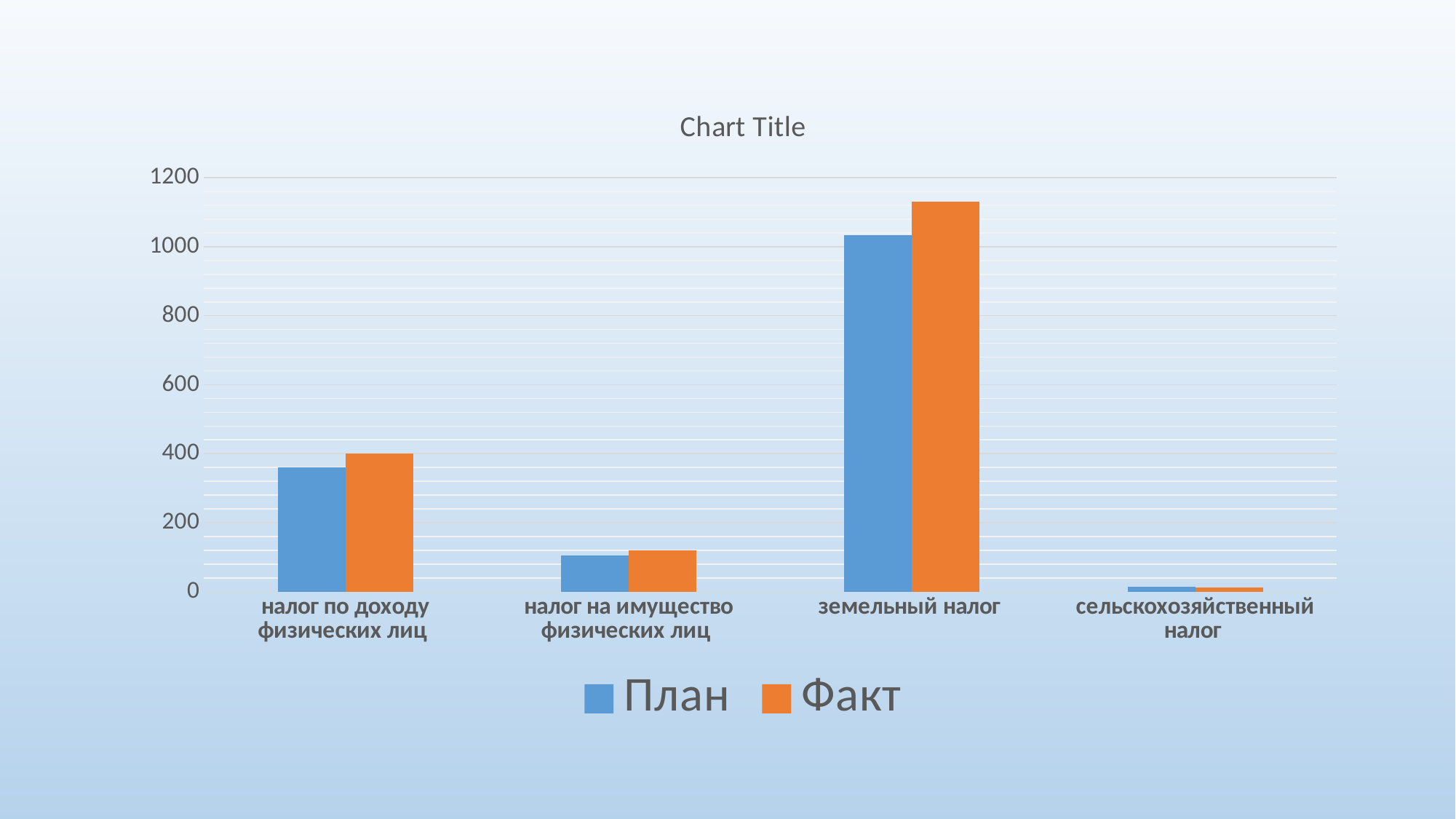
Is the План value for налог по доходу физических лиц greater or less than 400? less What kind of chart is shown on the slide? bar chart Which category has the lowest План value? сельскохозяйственный налог How many categories are shown on the x axis? 4 For земельный налог, which is larger: План or Факт? Факт Is the Факт value for земельный налог greater or less than 1000? greater What is the title of the chart? Chart Title How many series does the legend list? 2 Is the Факт value for налог на имущество физических лиц greater or less than 200? less Which colour represents the Факт series in the legend? orange Which category has the highest Факт value? земельный налог Which is larger: the План value for налог по доходу физических лиц or the План value for налог на имущество физических лиц? налог по доходу физических лиц